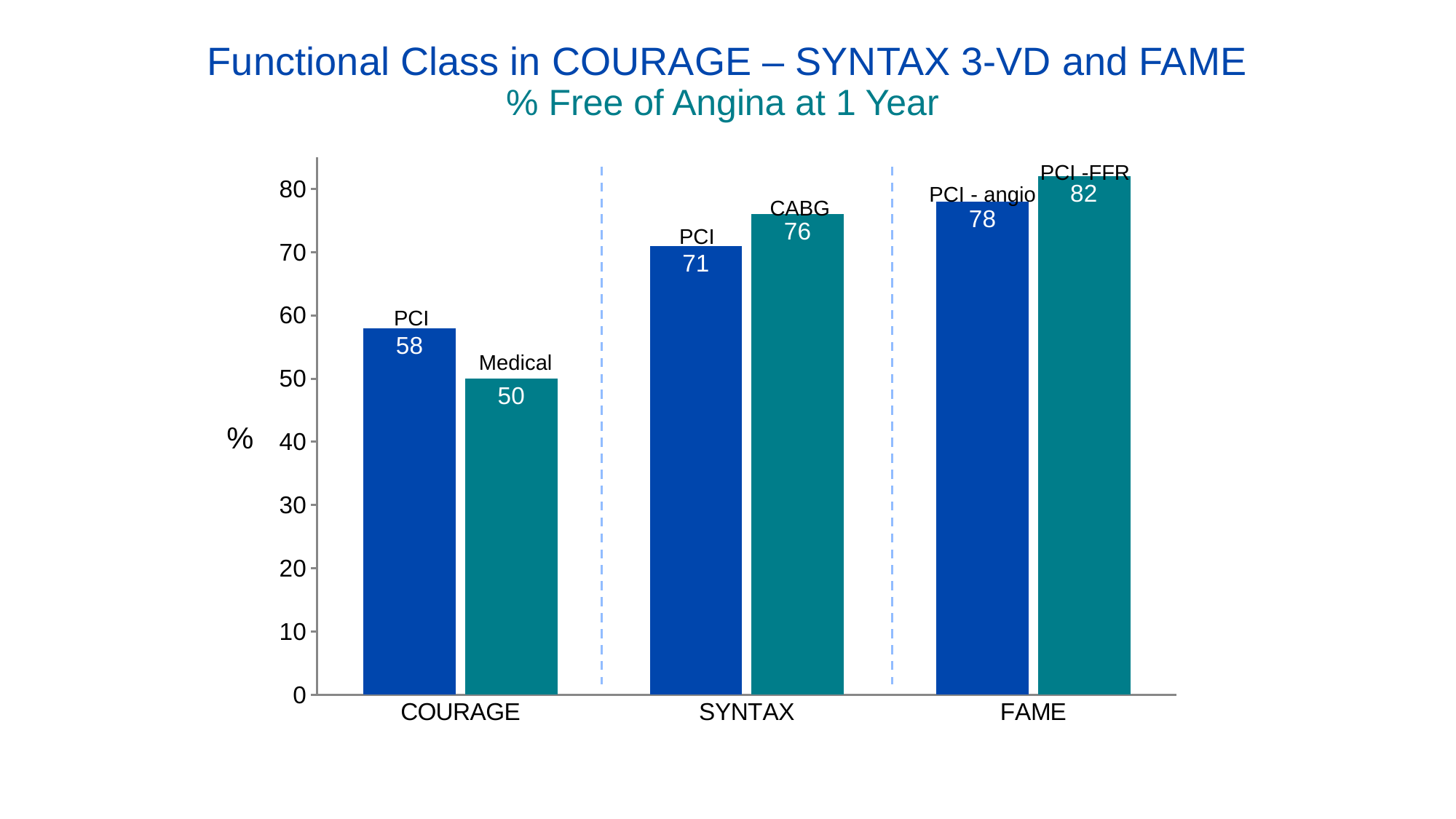
How many trials are shown along the x axis? 3 What kind of chart is shown on the slide? Bar chart What is the difference between CABG and PCI in the SYNTAX trial? 5 Which bar has the lowest value on the chart? Medical (COURAGE) What is the subtitle of the chart? % Free of Angina at 1 Year What is the value for PCI-FFR in the FAME trial? 82 What is the value for Medical in the COURAGE trial? 50 What is the difference between PCI and Medical in the COURAGE trial? 8 What is the value for CABG in the SYNTAX trial? 76 Which bar has the highest value on the chart? PCI-FFR (FAME) Which is larger in the FAME trial, PCI-angio or PCI-FFR? PCI-FFR What is the value for PCI in the COURAGE trial? 58